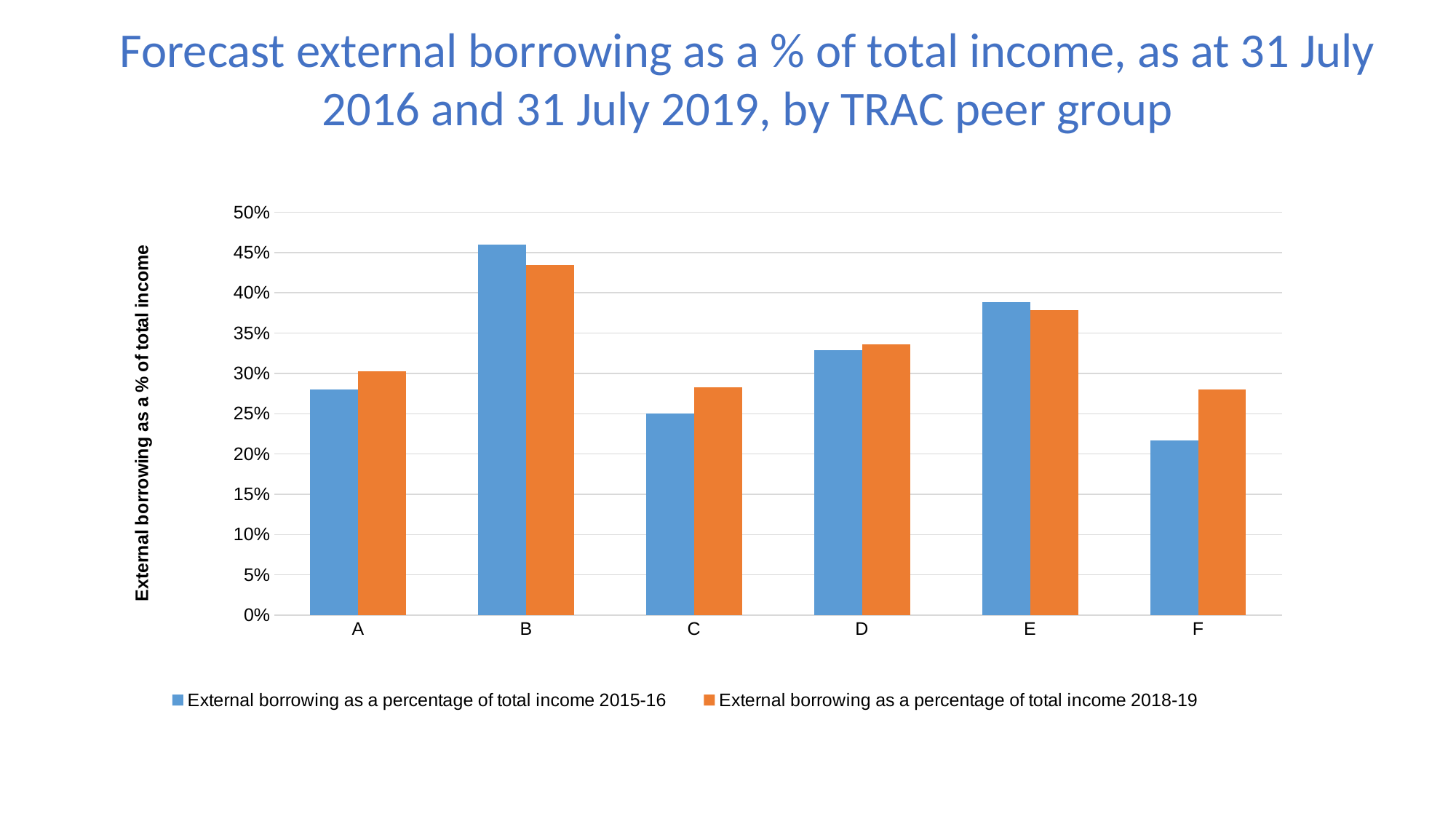
Which peer group has the lowest external borrowing as a percentage of total income in 2015-16? F What kind of chart is shown on the slide? bar chart How many peer groups are shown on the x axis? 6 Is the 2015-16 value for peer group F greater or less than 25%? less Which peer group has the highest external borrowing as a percentage of total income in 2018-19? B Is the 2015-16 value for peer group B greater or less than 40%? greater For peer group B, which is larger: the 2015-16 value or the 2018-19 value? 2015-16 Which peer group has the highest external borrowing as a percentage of total income in 2015-16? B What is the label on the vertical axis? External borrowing as a % of total income How many series does the legend list? 2 For peer group F, which is larger: the 2015-16 value or the 2018-19 value? 2018-19 Is the 2018-19 value for peer group D greater or less than 30%? greater